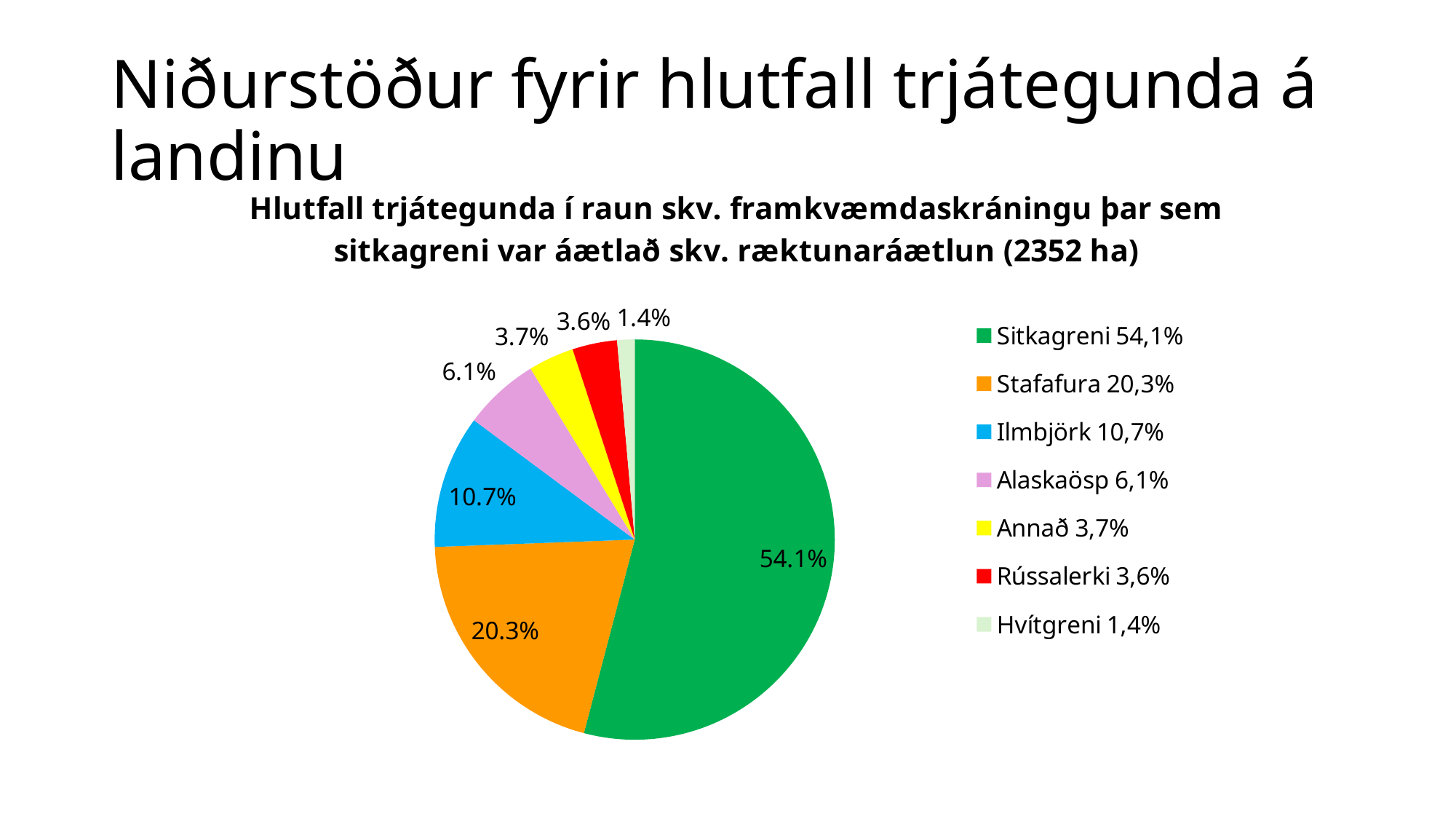
What share of the pie does Sitkagreni have? 54.1% What is the value shown for Ilmbjörk? 10.7% What kind of chart is shown on the slide? pie chart What colour is the slice for Rússalerki? red What is the value shown for Stafafura? 20.3% Which tree species has the largest slice of the pie? Sitkagreni Which is larger, the slice for Ilmbjörk or the slice for Alaskaösp? Ilmbjörk Which tree species has the smallest slice of the pie? Hvítgreni What is the difference in percentage points between Sitkagreni and Stafafura? 33.8 What is the value shown for Alaskaösp? 6.1% How many categories does the pie chart have? 7 What is the value shown for Hvítgreni? 1.4%